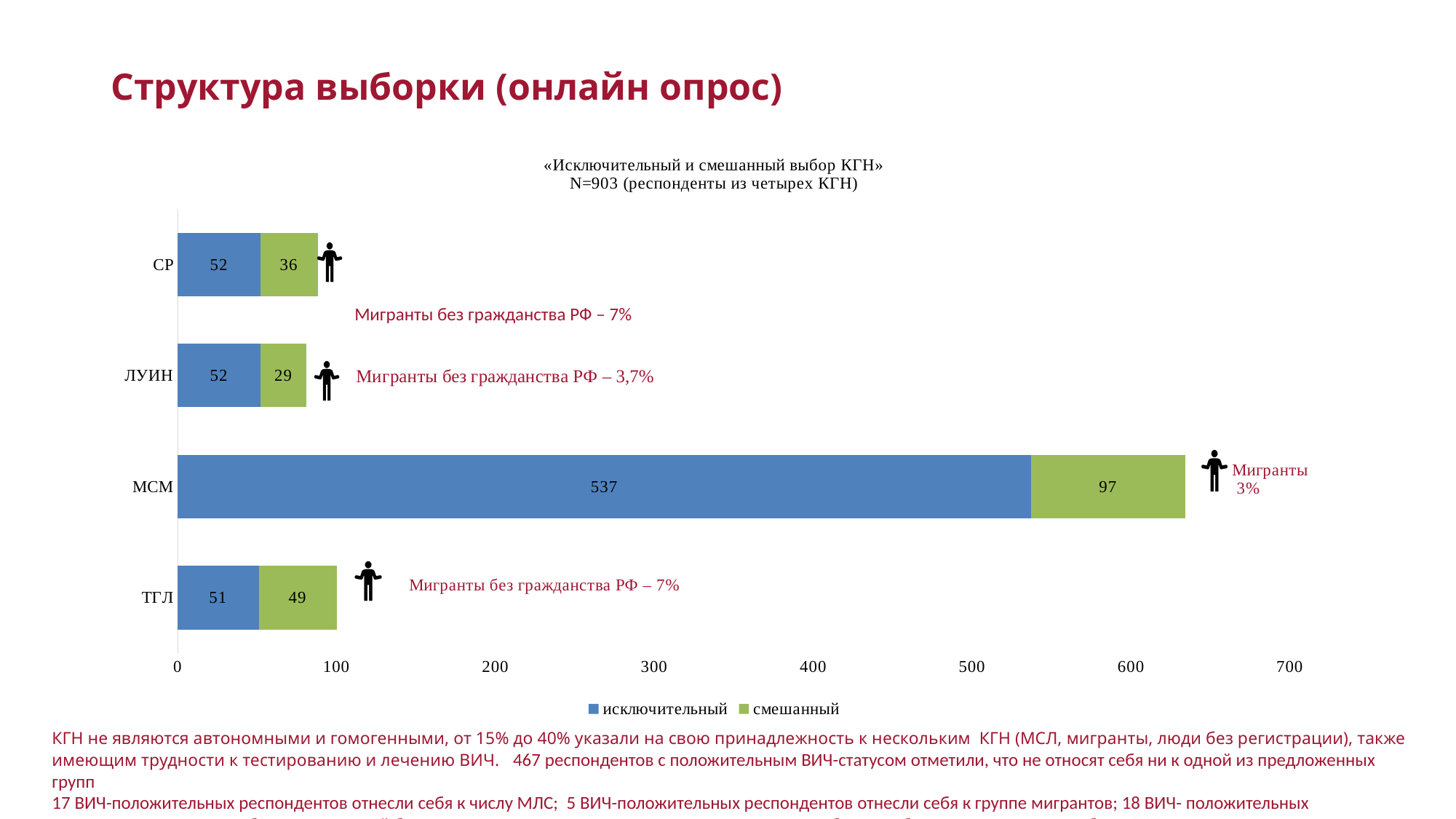
Which is larger: the 'смешанный' value for СР or for ЛУИН? СР How many series does the legend list? 2 What is the difference between the 'смешанный' values for ТГЛ and СР? 13 Which category has the lowest value for the 'смешанный' series? ЛУИН How many categories are shown on the y axis of the chart? 4 Which category has the highest value for the 'исключительный' series? МСМ What is the total of the stacked bar for МСМ? 634 What is the value of the 'исключительный' series for СР? 52 What is the value of the 'смешанный' series for ЛУИН? 29 What type of chart is shown on the slide? Stacked bar chart What is the value of the 'смешанный' series for ТГЛ? 49 What is the value of the 'исключительный' series for МСМ? 537